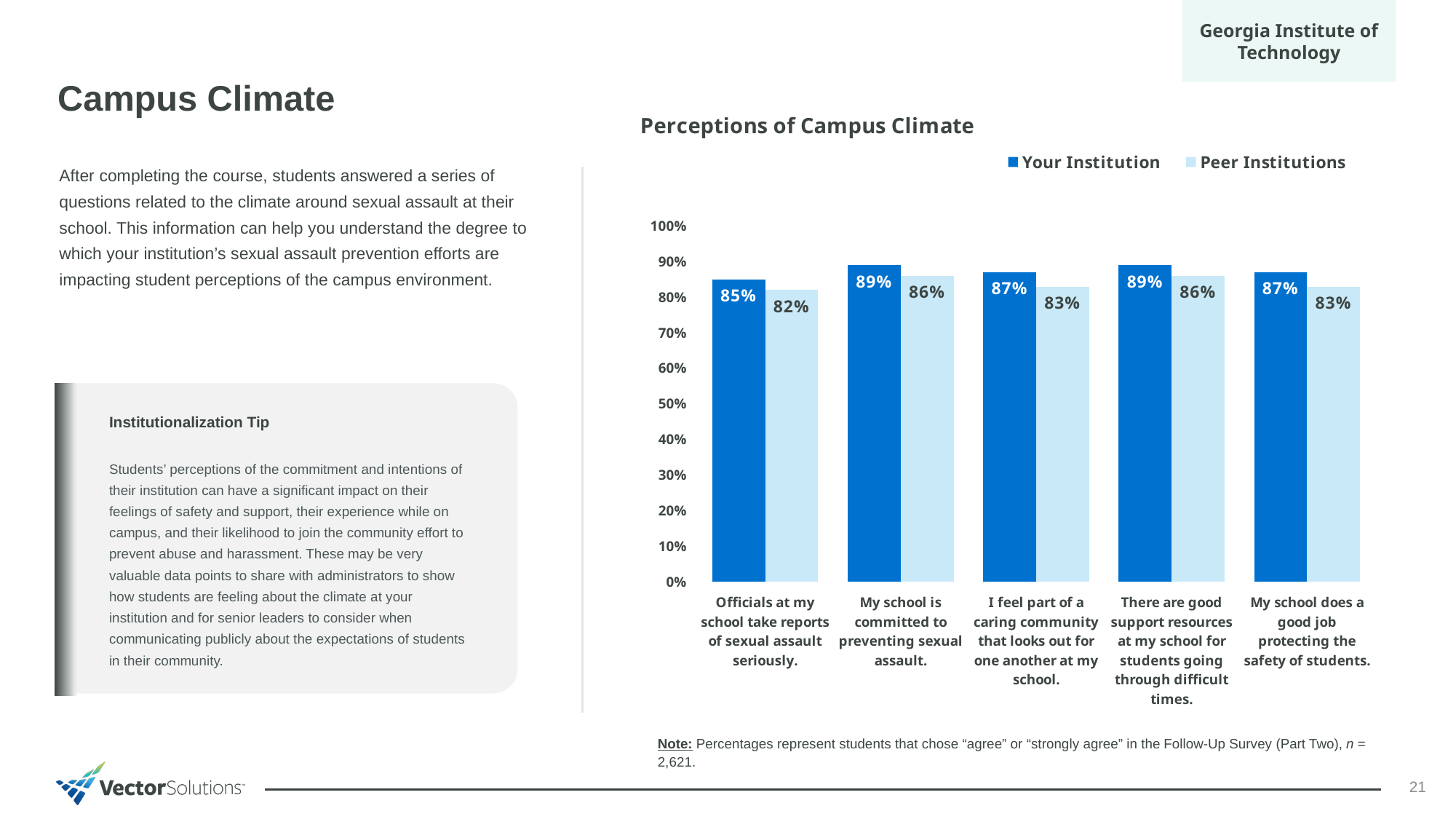
How many series does the legend list? 2 What is the value for Your Institution for "Officials at my school take reports of sexual assault seriously."? 85% What is the value for Peer Institutions for "I feel part of a caring community that looks out for one another at my school."? 83% What is the title of the chart? Perceptions of Campus Climate What is the value for Your Institution for "My school does a good job protecting the safety of students."? 87% Which category has the lowest Your Institution value? Officials at my school take reports of sexual assault seriously. What kind of chart is shown? Bar chart What is the value for Peer Institutions for "My school is committed to preventing sexual assault."? 86% How many categories are shown on the x axis? 5 For "Officials at my school take reports of sexual assault seriously.", which is larger: Your Institution or Peer Institutions? Your Institution What is the difference between Your Institution and Peer Institutions for "There are good support resources at my school for students going through difficult times."? 3% What is the difference between Your Institution and Peer Institutions for "I feel part of a caring community that looks out for one another at my school."? 4%